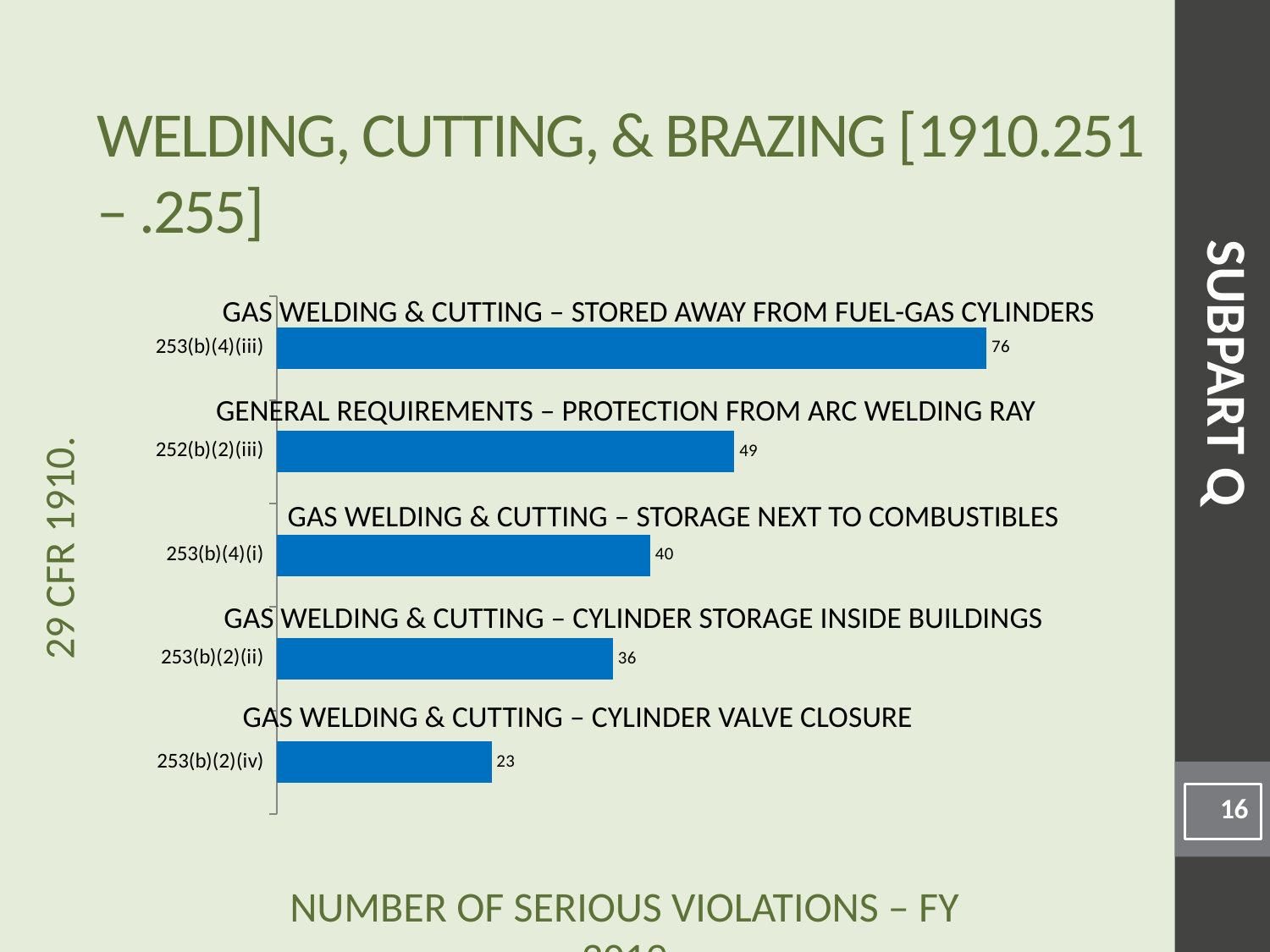
What kind of chart is shown on the slide? Bar chart Which category has the highest number of serious violations? 253(b)(4)(iii) Which has more serious violations, 253(b)(4)(i) or 253(b)(2)(iv)? 253(b)(4)(i) What is the number of serious violations for 253(b)(4)(iii)? 76 What is the number of serious violations for 252(b)(2)(iii)? 49 Which category has the lowest number of serious violations? 253(b)(2)(iv) What is the value for 253(b)(2)(ii)? 36 What is the difference between the values for 253(b)(4)(iii) and 252(b)(2)(iii)? 27 What is the number of serious violations for 253(b)(2)(iv)? 23 Which category is described as 'GAS WELDING & CUTTING – STORAGE NEXT TO COMBUSTIBLES'? 253(b)(4)(i) How many categories are shown in the chart? 5 What is the difference between the values for 253(b)(4)(i) and 253(b)(2)(ii)? 4